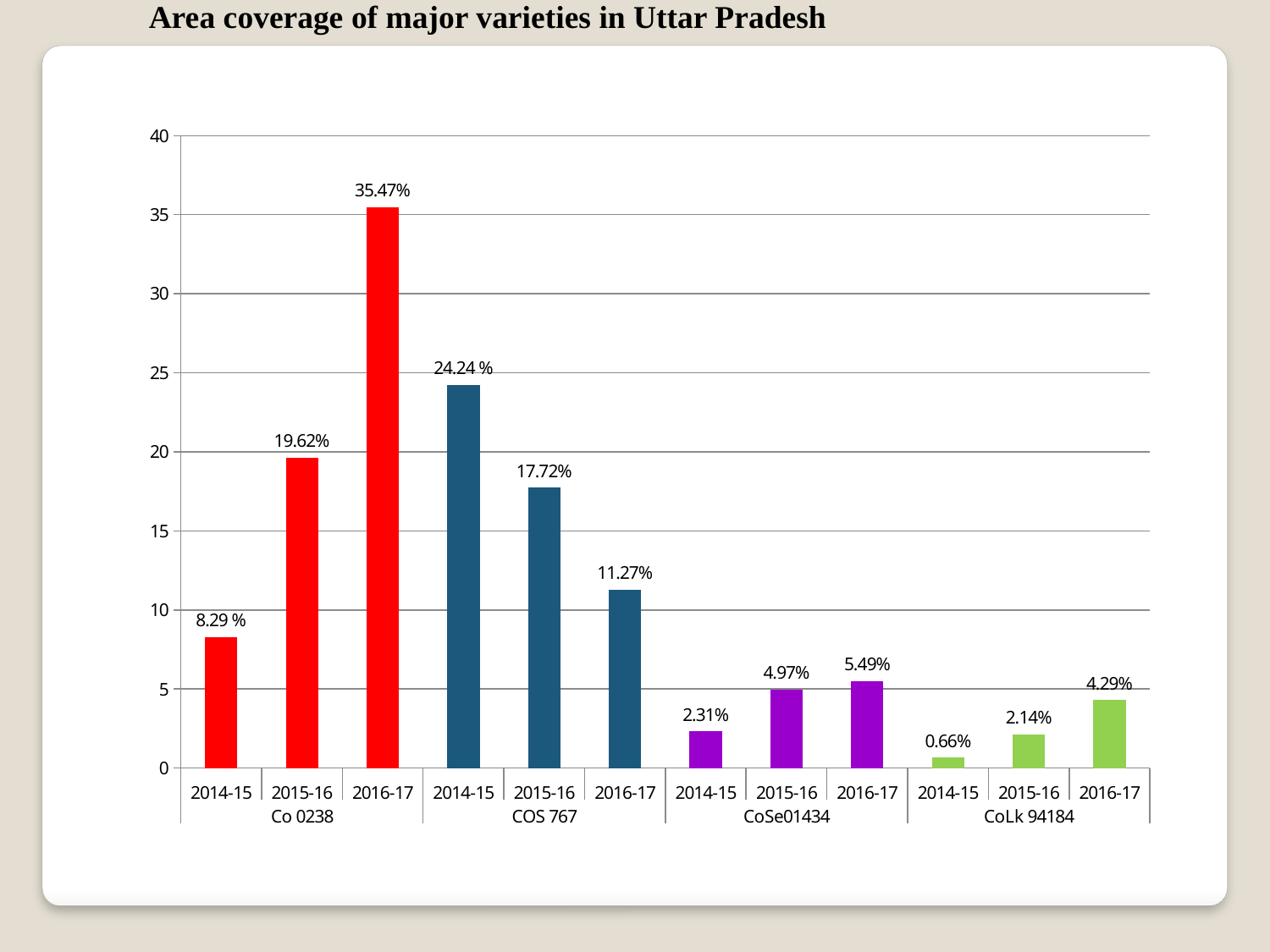
What is the difference between the area coverage of Co 0238 in 2016-17 and in 2015-16? 15.85% Which bar has the lowest value on the chart? CoLk 94184, 2014-15 What is the area coverage of Co 0238 in 2016-17? 35.47% What is the area coverage of CoLk 94184 in 2014-15? 0.66% What kind of chart is shown on the slide? Bar chart What is the area coverage of COS 767 in 2014-15? 24.24 % Which is larger: COS 767 in 2015-16 or Co 0238 in 2015-16? Co 0238 in 2015-16 What is the area coverage of CoSe01434 in 2015-16? 4.97% Do the values for COS 767 rise or fall from 2014-15 to 2016-17? Fall How many varieties are shown on the chart? 4 Is the value for COS 767 in 2016-17 greater or less than 10? greater Which bar has the highest value on the chart? Co 0238, 2016-17